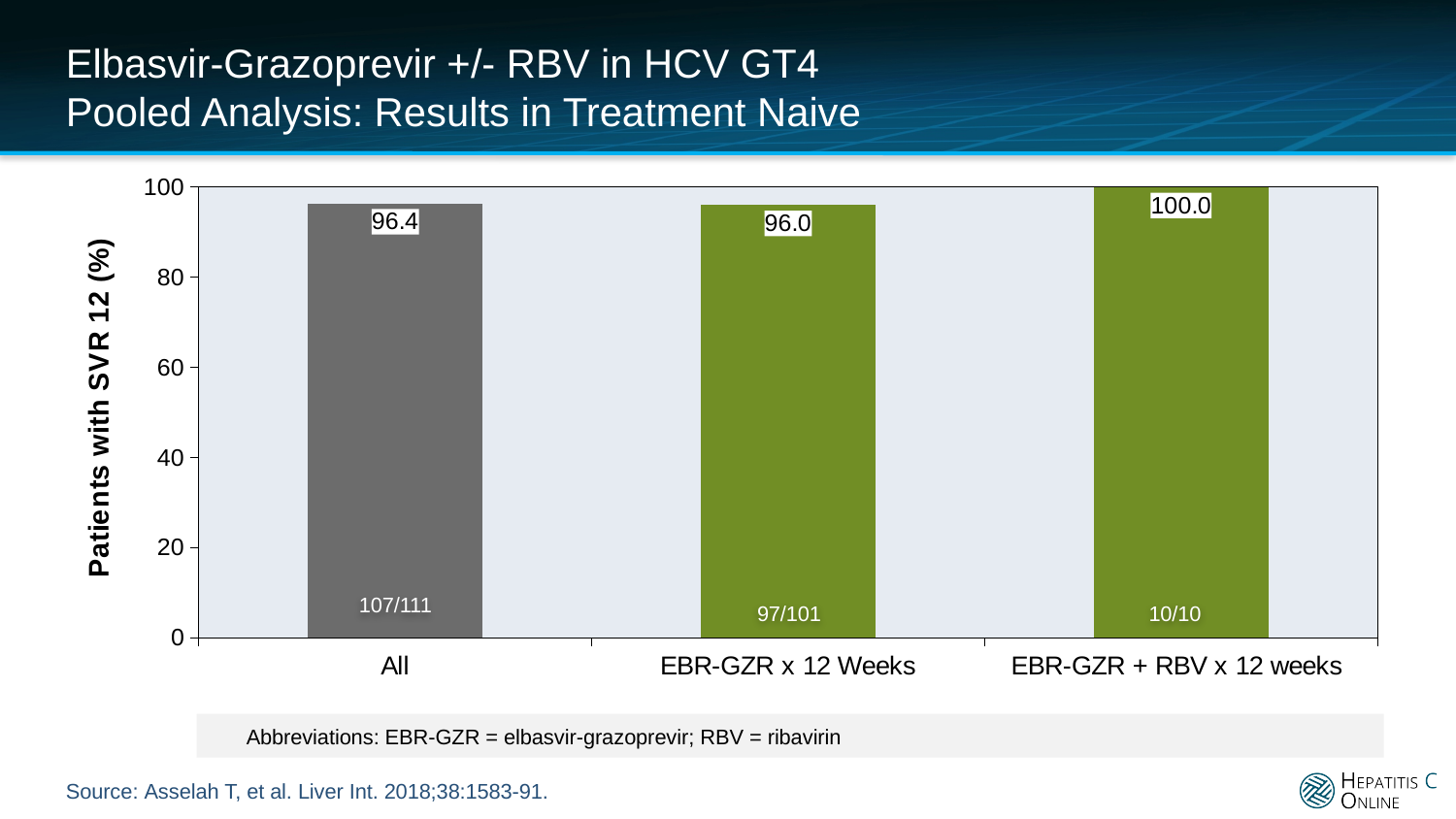
How many groups are shown on the x axis? 3 What is the SVR 12 rate for EBR-GZR x 12 Weeks? 96.0 What kind of chart is shown on the slide? bar chart Which group has the highest SVR 12 rate? EBR-GZR + RBV x 12 weeks Which group has the lowest SVR 12 rate? EBR-GZR x 12 Weeks Which has a higher SVR 12 rate, All or EBR-GZR x 12 Weeks? All What is the SVR 12 rate for EBR-GZR + RBV x 12 weeks? 100.0 What is the label of the y axis? Patients with SVR 12 (%) Is the SVR 12 rate for EBR-GZR x 12 Weeks greater or less than 80? greater What is the difference in SVR 12 rate between EBR-GZR + RBV x 12 weeks and EBR-GZR x 12 Weeks? 4.0 How many patients achieved SVR 12 in the EBR-GZR x 12 Weeks group, as shown in the bar label? 97/101 What is the SVR 12 rate for the All group? 96.4